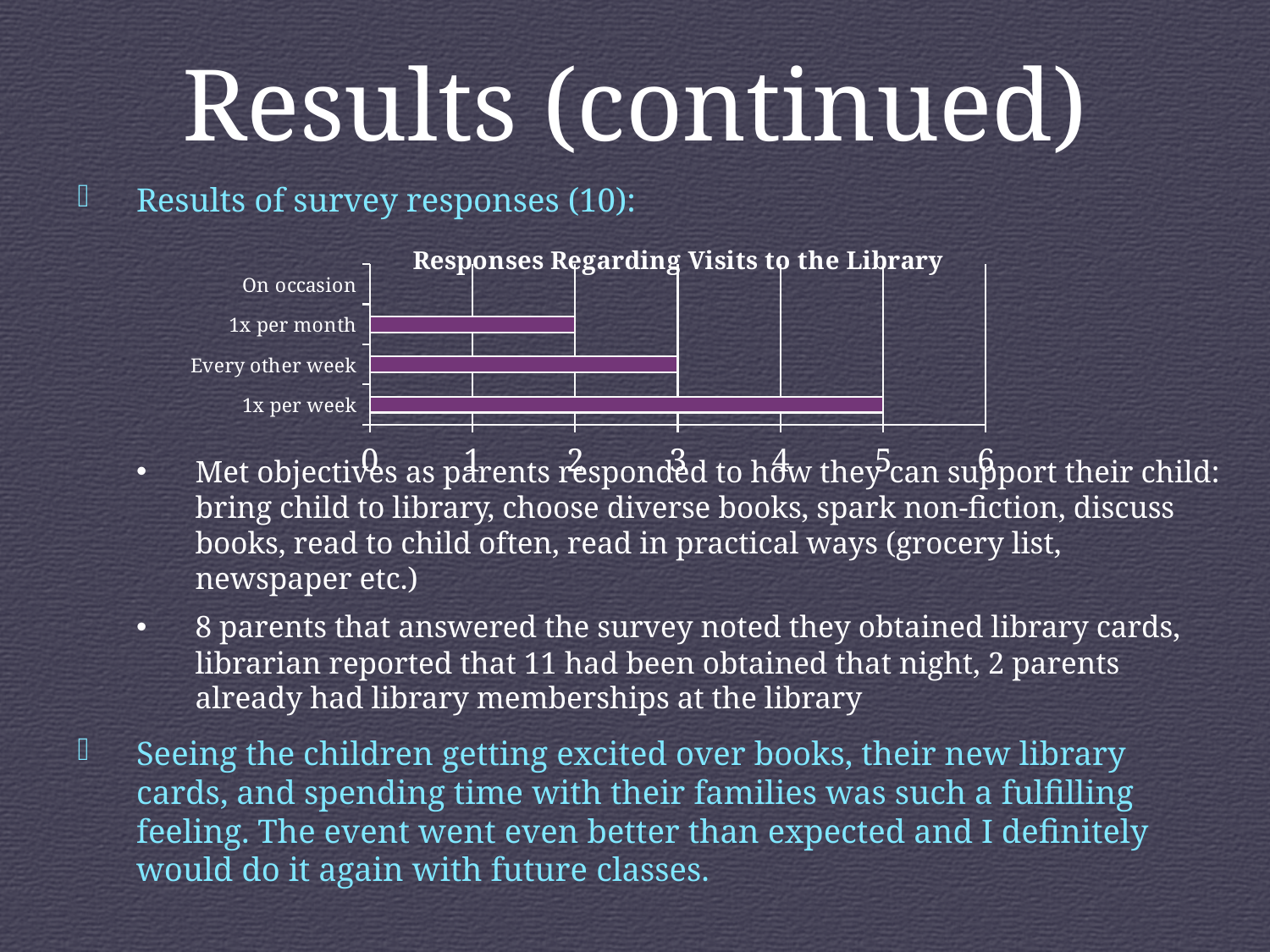
What is the difference between the values for "Every other week" and "1x per month"? 1 Which category has the lowest value? On occasion What is the value for "Every other week"? 3 What is the difference between the values for "1x per week" and "Every other week"? 2 Is the value for "1x per week" greater or less than 4? greater Which category has the highest value? 1x per week What is the value for "1x per week"? 5 How many categories are shown on the chart's vertical axis? 4 What is the value for "1x per month"? 2 What is the title of the chart? Responses Regarding Visits to the Library Which is larger, the value for "1x per month" or the value for "1x per week"? 1x per week What kind of chart is shown on the slide? bar chart